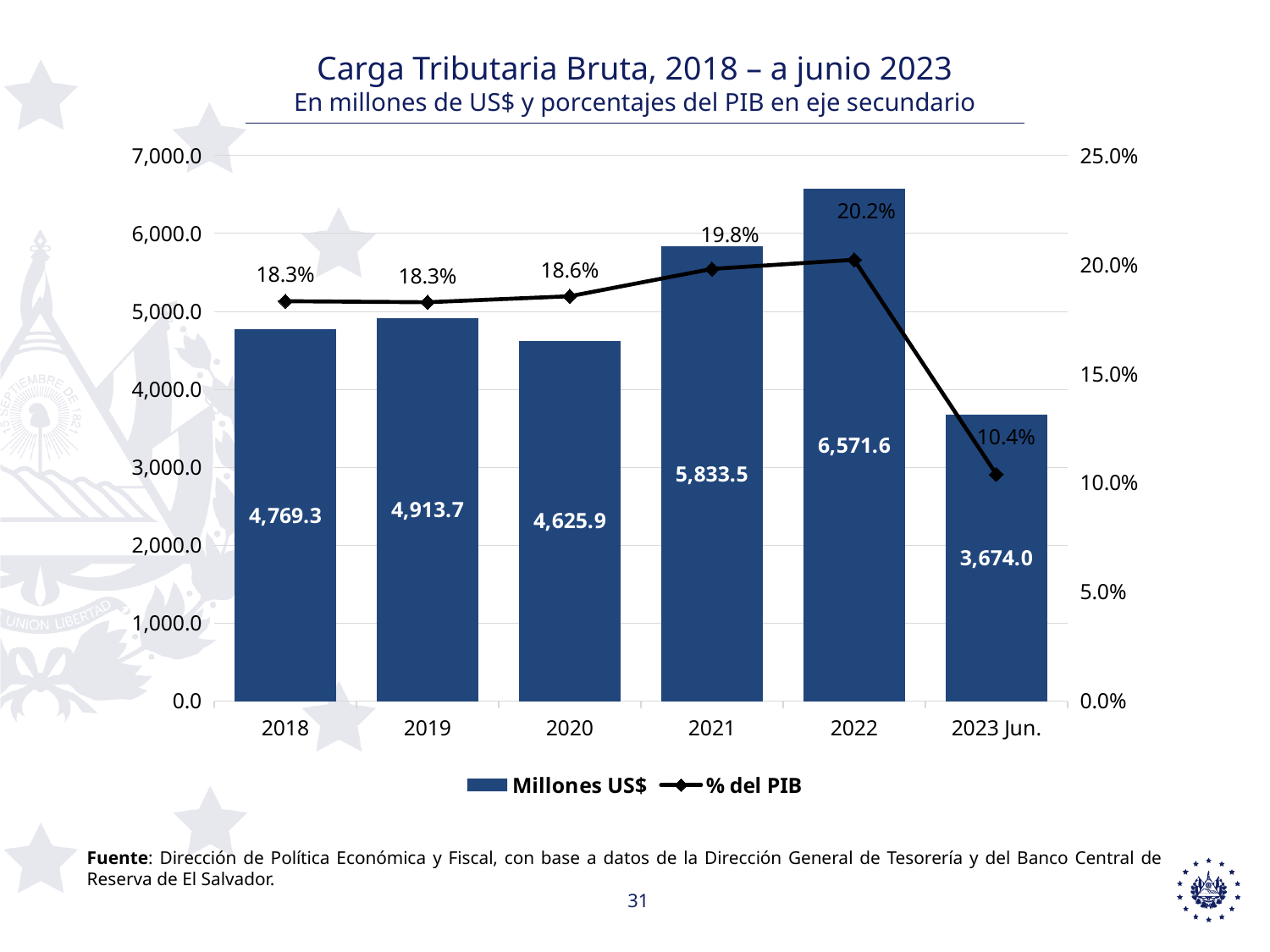
What is the value of Millones US$ for 2023 Jun.? 3,674.0 How many series does the legend list? 2 What kind of chart is this? Combined bar and line chart Which is larger, the Millones US$ value for 2019 or for 2020? 2019 Does the % del PIB line rise or fall from 2018 to 2022? Rise What is the value of Millones US$ for 2022? 6,571.6 What is the difference in Millones US$ between 2022 and 2021? 738.1 What is the title of the chart? Carga Tributaria Bruta, 2018 – a junio 2023 Which year has the highest Millones US$ value? 2022 How many categories are shown on the x axis? 6 Which category has the lowest % del PIB value? 2023 Jun. What is the % del PIB value for 2021? 19.8%